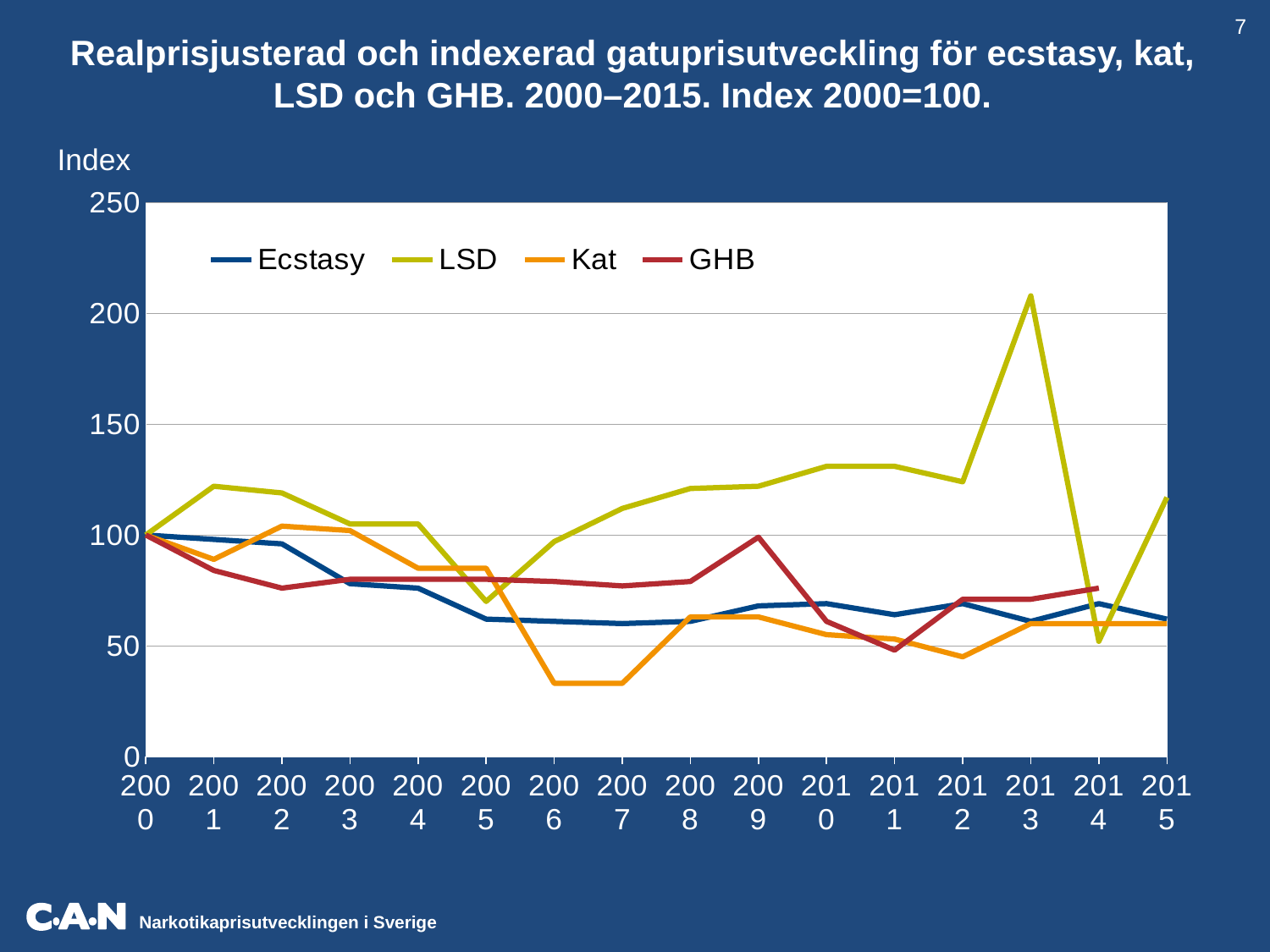
Which series has the highest value in 2013? LSD What is the index value for Ecstasy in 2000? 100 In 2015, which is larger, the value for LSD or the value for Ecstasy? LSD How many series does the legend list? 4 What kind of chart is shown on the slide? line chart Which series has the lowest value in 2007? Kat Is the value for LSD in 2010 greater or less than 100? greater How many years are shown along the x axis? 16 Is the value for Kat in 2006 greater or less than 50? less Does the Ecstasy line rise or fall from 2000 to 2005? fall Is the value for LSD in 2013 greater or less than 200? greater